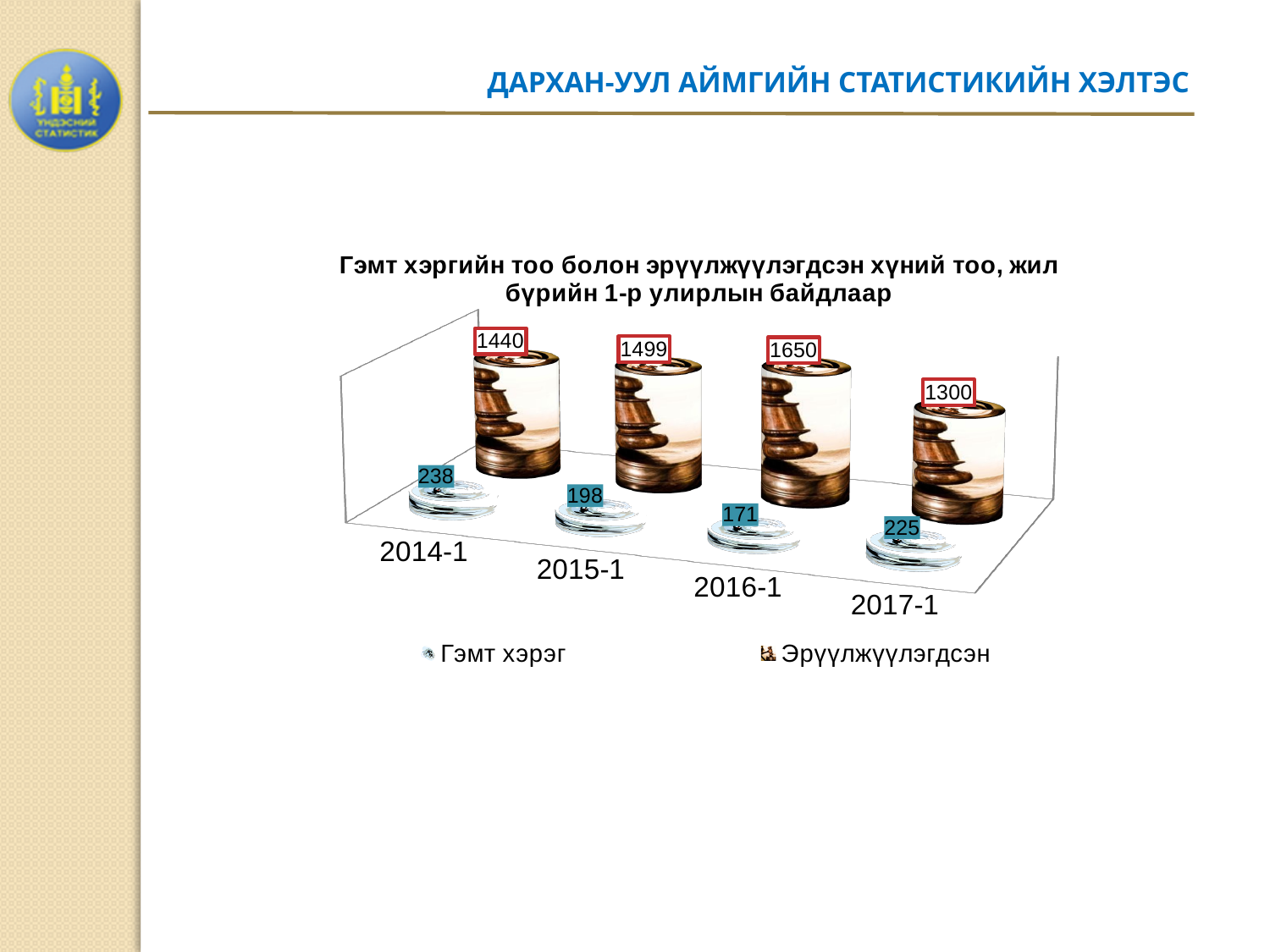
What is the difference between the Гэмт хэрэг values for 2014-1 and 2016-1? 67 How many periods are shown on the x axis? 4 Which is larger: the Гэмт хэрэг value for 2014-1 or for 2017-1? 2014-1 What is the value for Эрүүлжүүлэгдсэн in 2014-1? 1440 What is the value for Гэмт хэрэг in 2017-1? 225 What is the value for Эрүүлжүүлэгдсэн in 2016-1? 1650 In which period is the Гэмт хэрэг value lowest? 2016-1 In which period is the Эрүүлжүүлэгдсэн value highest? 2016-1 What is the difference between the Эрүүлжүүлэгдсэн values for 2016-1 and 2017-1? 350 How many series does the legend list? 2 What is the value for Гэмт хэрэг in 2015-1? 198 What kind of chart is shown on the slide? Bar chart